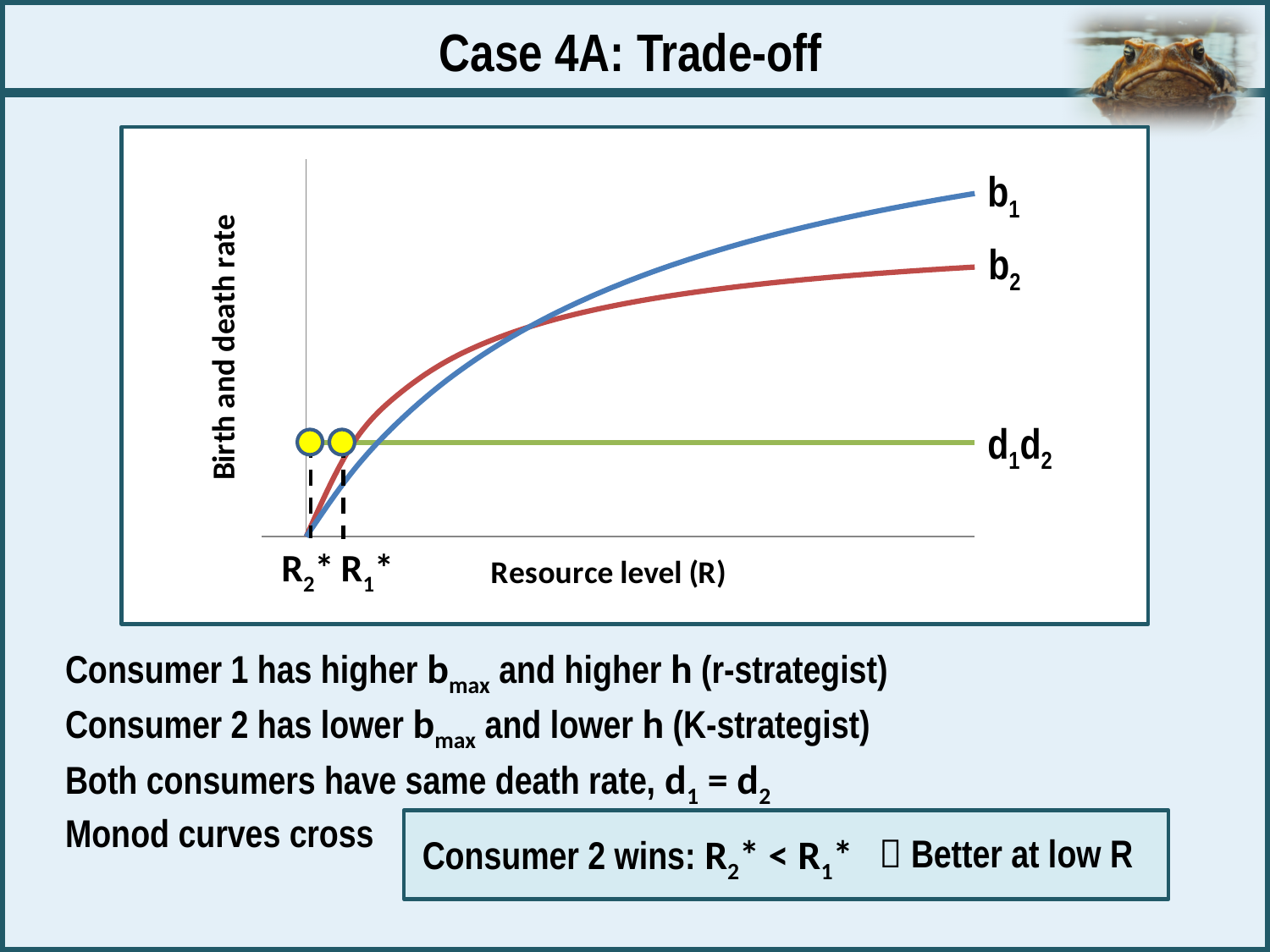
Which curve reaches the highest value at the right edge of the chart? b1 At high resource levels (right side of the chart), which curve is higher, b1 or b2? b1 What is the label of the y axis of the chart? Birth and death rate Which of the two break-even resource levels is smaller, R1* or R2*? R2* At low resource levels just above R1*, which curve is higher, b1 or b2? b2 What is the label of the x axis of the chart? Resource level (R) Does the d1d2 line rise, fall, or stay flat as resource level R increases? stay flat Does the b1 curve rise or fall as resource level R increases? rise Do the b1 and b2 curves cross each other on the chart? yes How many curves or lines are plotted on the chart? 3 What kind of chart is shown on the slide? line chart